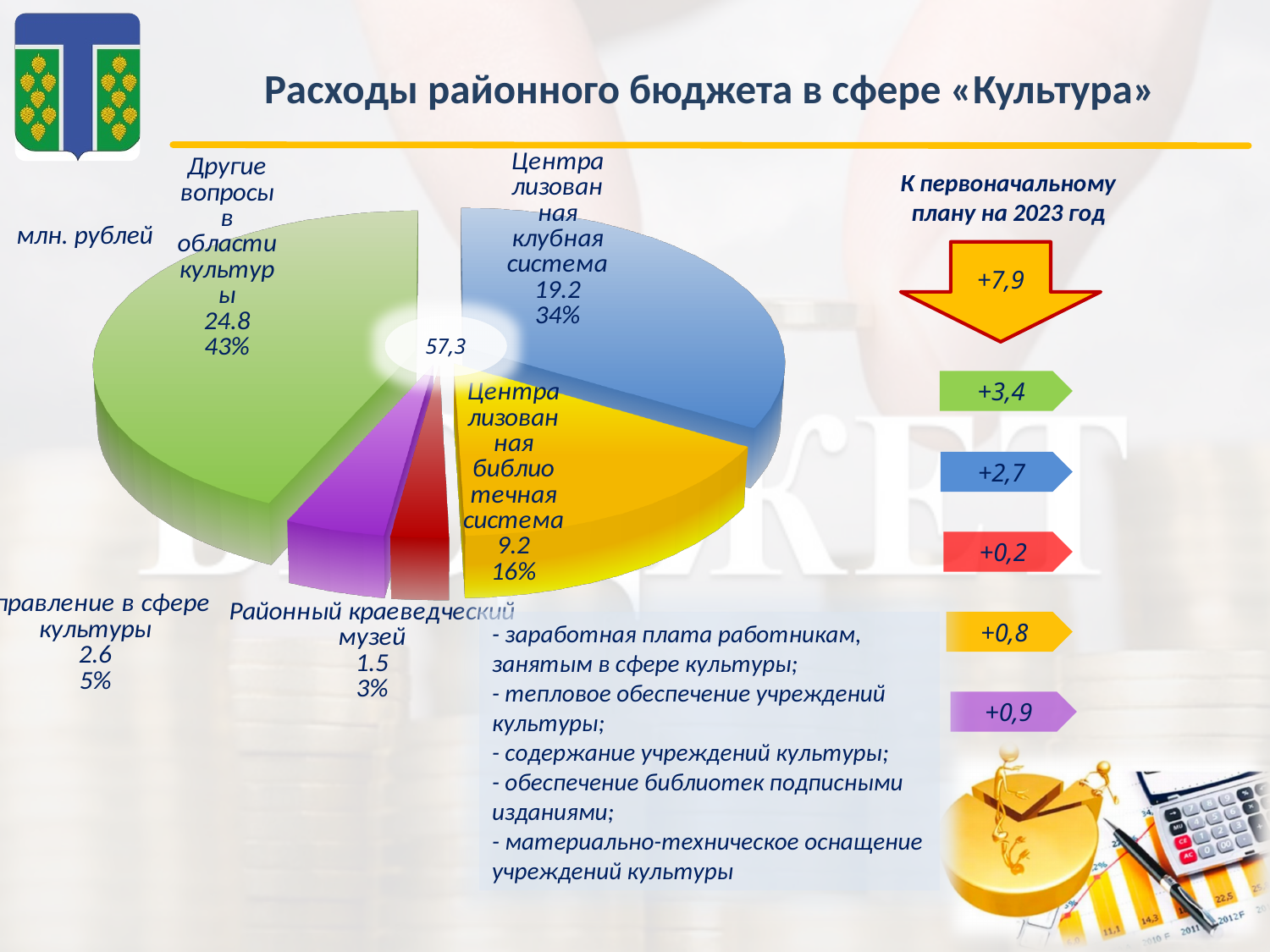
What is the difference between the values for «Другие вопросы в области культуры» and «Централизованная клубная система»? 5.6 Which is larger: the value for «Управление в сфере культуры» or for «Районный краеведческий музей»? Управление в сфере культуры How many slices does the pie chart have? 5 Which category has the largest slice in the pie chart? Другие вопросы в области культуры What is the title of the slide containing the pie chart? Расходы районного бюджета в сфере «Культура» What share of the pie does «Районный краеведческий музей» represent? 3% What total value is shown in the centre of the pie chart? 57,3 What is the value for «Централизованная библиотечная система»? 9.2 What kind of chart is shown on the slide? pie chart Which category has the smallest slice in the pie chart? Районный краеведческий музей What share of the pie does «Другие вопросы в области культуры» represent? 43% What is the value for «Централизованная клубная система» in the pie chart? 19.2